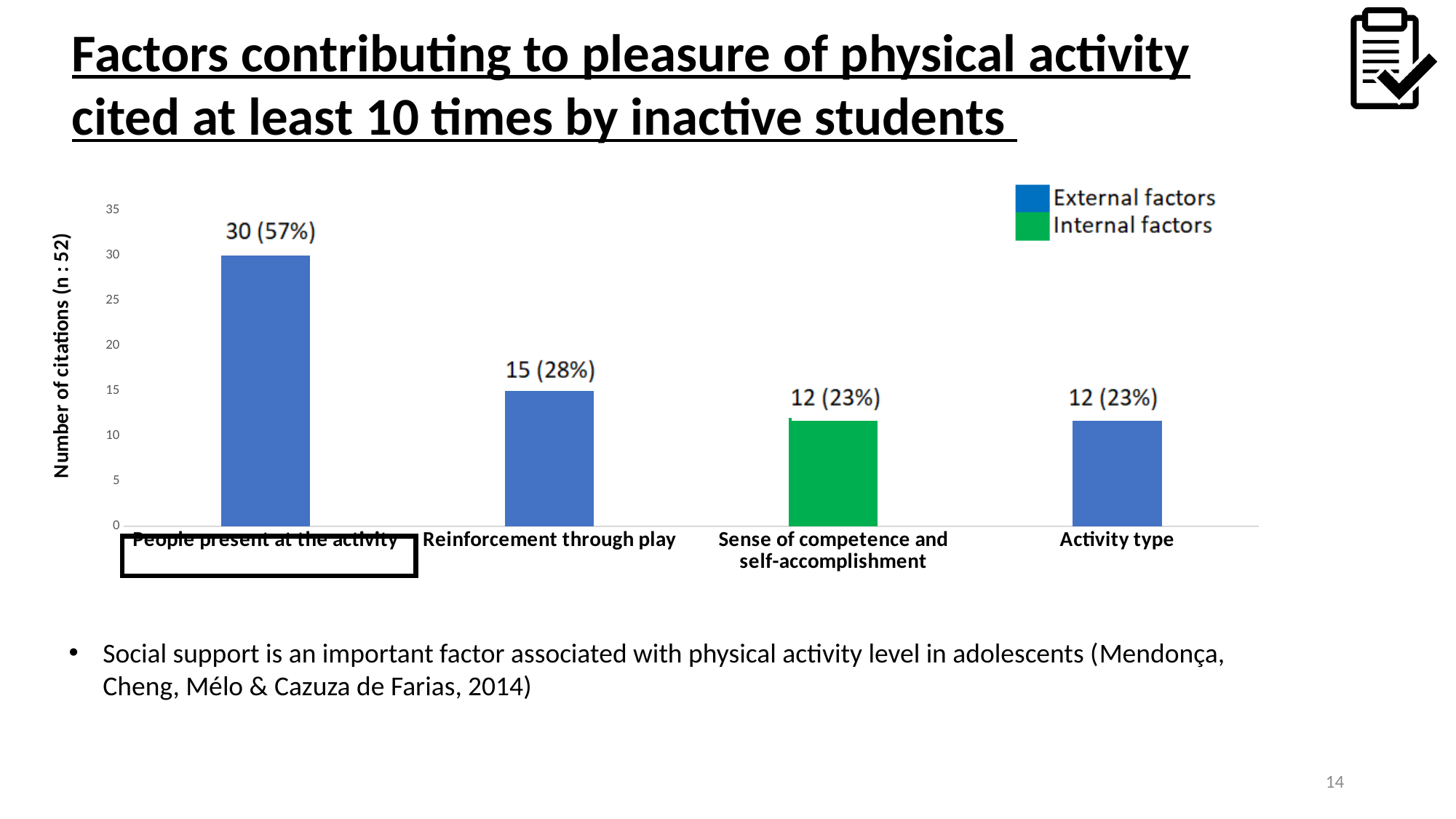
What is the data label shown for Sense of competence and self-accomplishment? 12 (23%) What is the data label shown for People present at the activity? 30 (57%) How many series does the legend list? 2 Which category has the highest number of citations? People present at the activity Is the number of citations for People present at the activity greater or less than 25? greater How many categories are shown on the x axis? 4 What kind of chart is shown on the slide? Bar chart What is the data label shown for Activity type? 12 (23%) What is the difference in number of citations between People present at the activity and Reinforcement through play? 15 What is the data label shown for Reinforcement through play? 15 (28%) Which category is shown in green, representing Internal factors? Sense of competence and self-accomplishment Which has more citations, Reinforcement through play or Activity type? Reinforcement through play